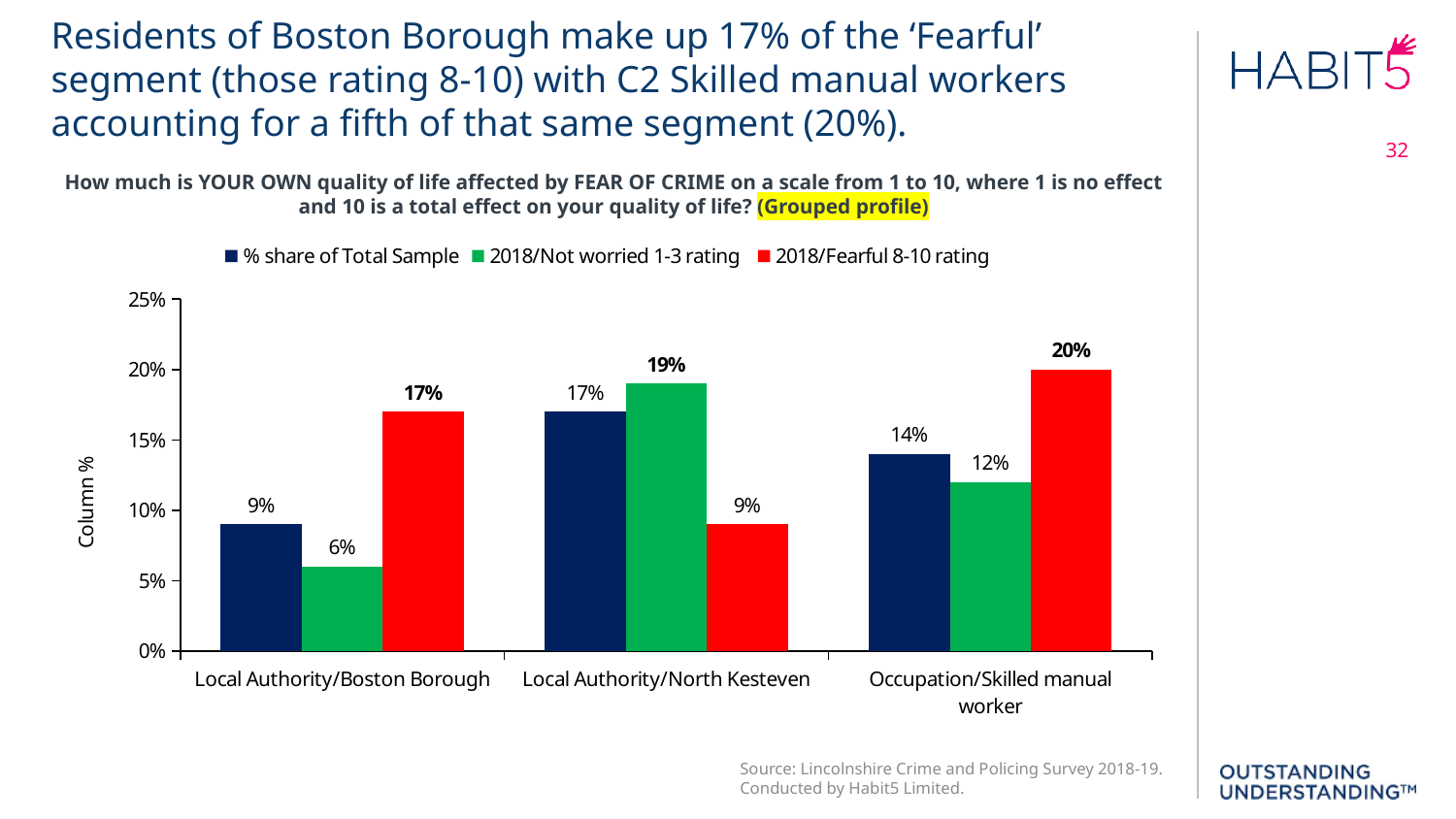
For Local Authority/North Kesteven, which is larger: the 2018/Not worried 1-3 rating or the 2018/Fearful 8-10 rating? 2018/Not worried 1-3 rating What is the label of the y axis? Column % How many series does the legend list? 3 Which category has the highest value for 2018/Fearful 8-10 rating? Occupation/Skilled manual worker What is the value for 2018/Fearful 8-10 rating for Local Authority/Boston Borough? 17% What is the % share of Total Sample for Occupation/Skilled manual worker? 14% What kind of chart is shown on the slide? Bar chart What is the value for 2018/Not worried 1-3 rating for Local Authority/North Kesteven? 19% Which category has the lowest value for 2018/Not worried 1-3 rating? Local Authority/Boston Borough How many categories are shown on the x axis? 3 Which colour represents the 2018/Fearful 8-10 rating series? Red What is the difference between the 2018/Fearful 8-10 rating and the 2018/Not worried 1-3 rating for Local Authority/Boston Borough? 11%